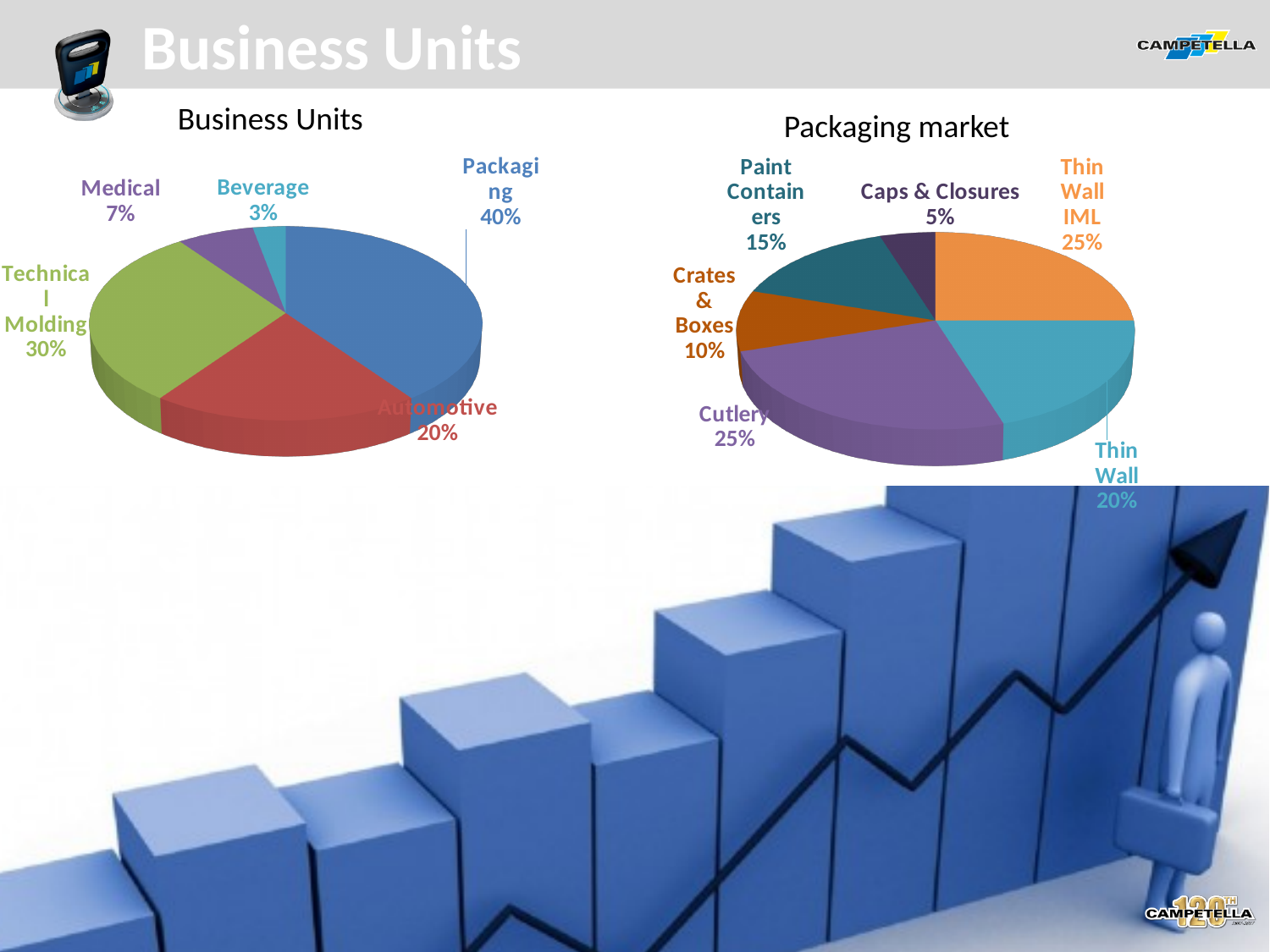
In the Business Units chart, what share does Packaging have? 40% In the Packaging market chart, what share does Crates & Boxes have? 10% In the Business Units chart, which category has the smallest share? Beverage In the Business Units chart, which category has the largest share? Packaging What kind of chart is the Packaging market chart? Pie chart In the Packaging market chart, which category has the smallest share? Caps & Closures In the Business Units chart, what is the difference between the Packaging and Automotive shares? 20% In the Business Units chart, what share does Technical Molding have? 30% In the Packaging market chart, which is larger, Thin Wall IML or Thin Wall? Thin Wall IML In the Packaging market chart, what share does Paint Containers have? 15% In the Business Units chart, how many categories are shown? 5 In the Packaging market chart, how many categories are shown? 6